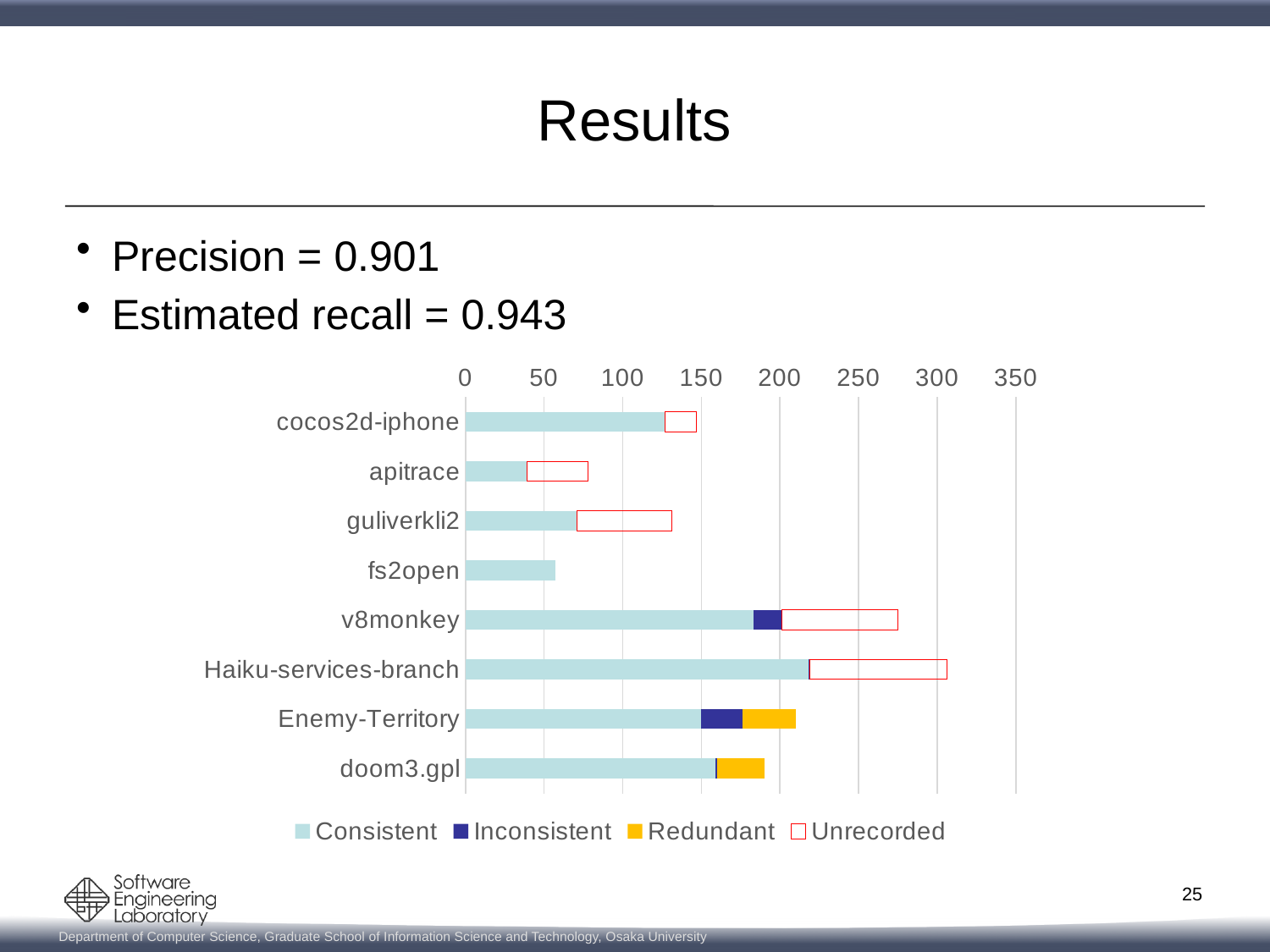
Is the total bar length for apitrace greater or less than 100? less Which legend entry is shown in yellow? Redundant Is the Consistent value for Haiku-services-branch greater or less than 200? greater What kind of chart is shown on the slide? bar chart Which project has a longer total bar, v8monkey or Enemy-Territory? v8monkey Is the total bar length for v8monkey greater or less than 250? greater How many series does the chart legend list? 4 Which project has the longest total bar in the chart? Haiku-services-branch Which legend entry is drawn as an unfilled (white) box? Unrecorded Which project has the shortest total bar in the chart? fs2open How many projects (categories) are plotted in the chart? 8